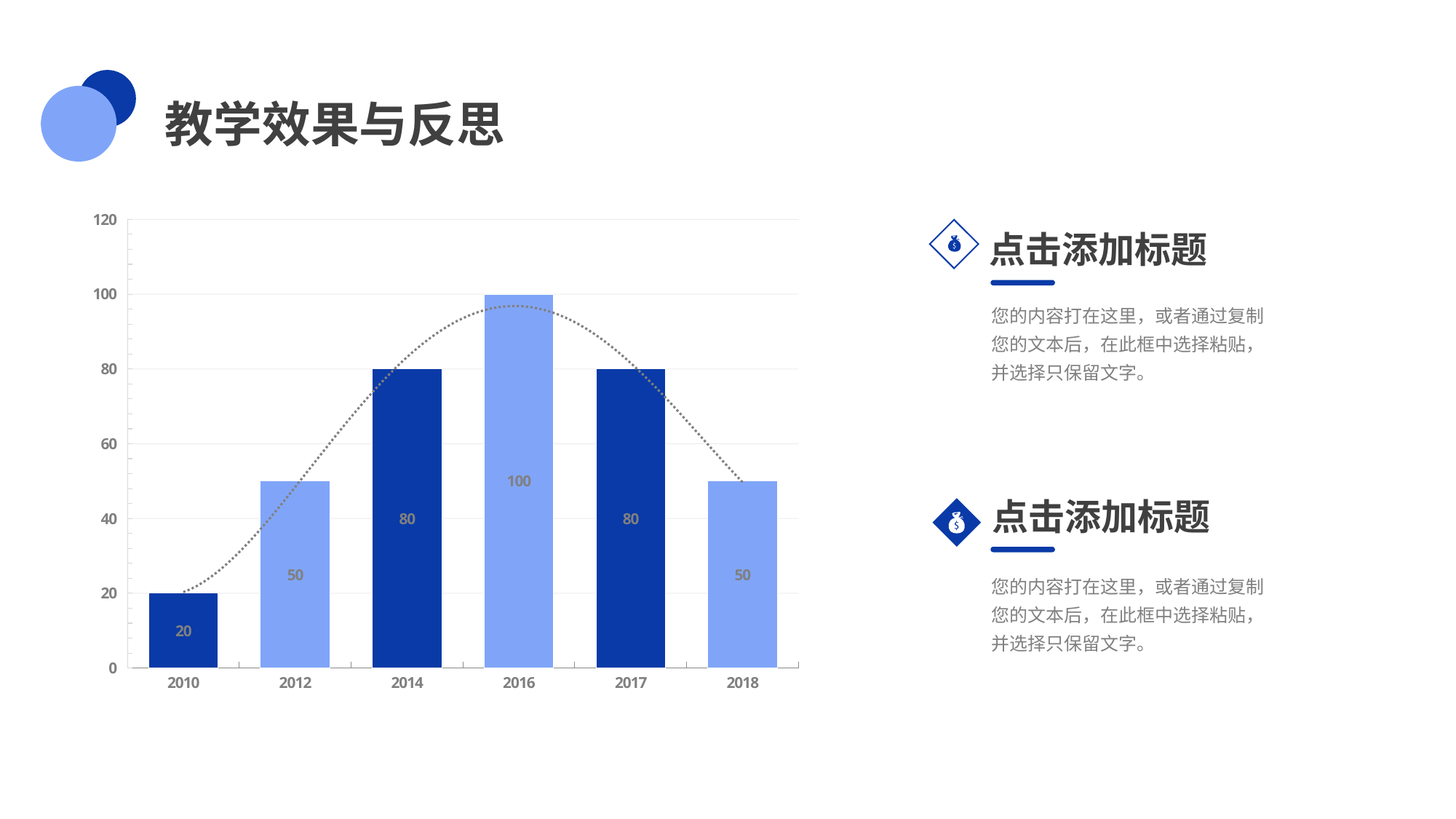
What is the value for 2010? 20 Which year has the highest value? 2016 What is the difference between the values for 2014 and 2010? 60 Do the values rise or fall from 2010 to 2016? rise What is the difference between the values for 2016 and 2012? 50 Which year has the lowest value? 2010 How many years are shown on the x axis? 6 What is the value for 2016? 100 What is the value for 2018? 50 Which is larger, the value for 2012 or the value for 2014? 2014 Is the value for 2017 greater or less than 60? greater What kind of chart is shown on the slide? bar chart